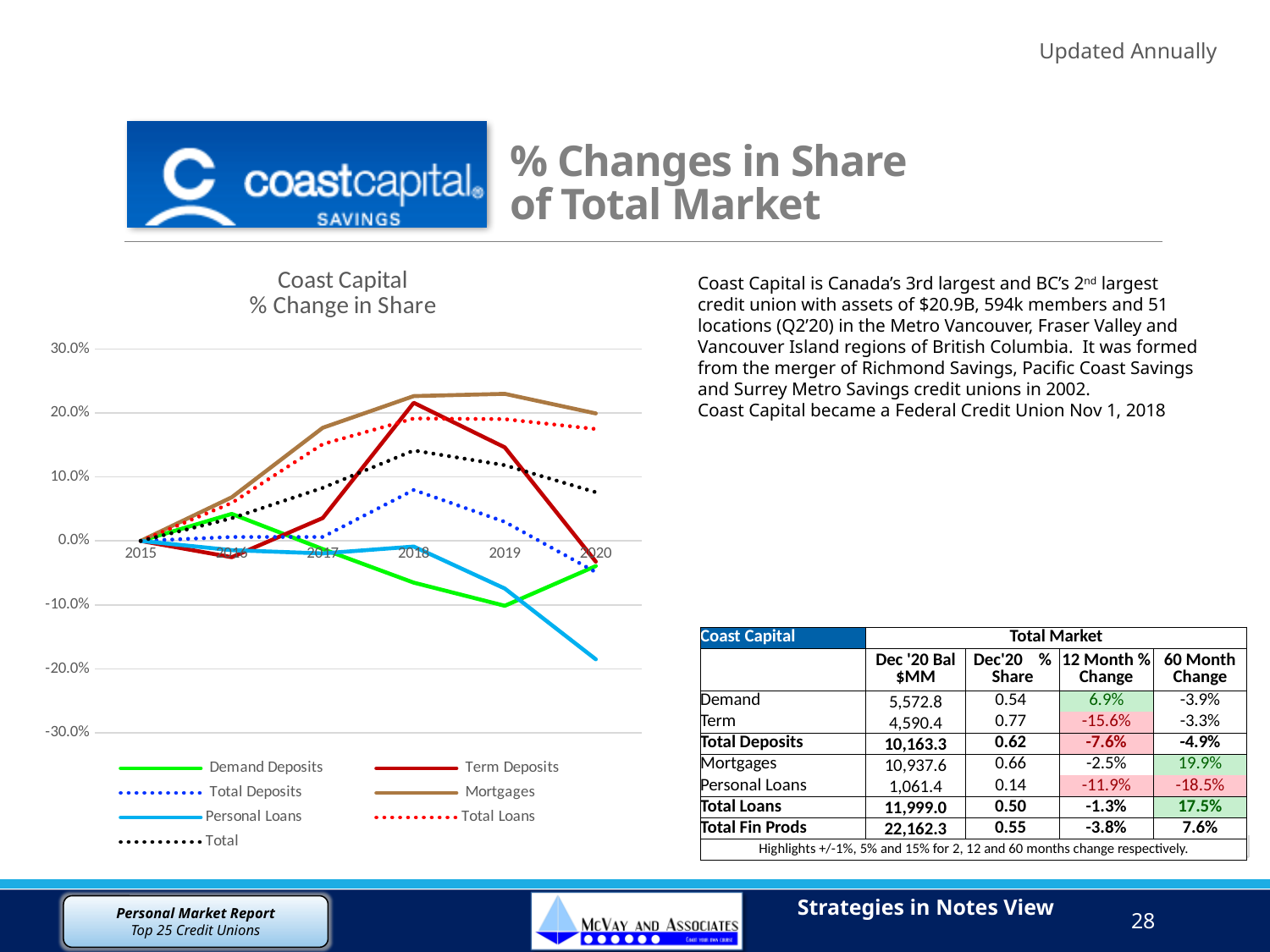
How many years are plotted along the x axis of the chart? 6 Is the value for Personal Loans in 2020 greater or less than -10.0%? less Is the value for Demand Deposits in 2019 greater or less than 0.0%? less What is the title of the chart? Coast Capital % Change in Share How many series does the legend of the chart list? 7 What kind of chart is shown on the slide? line chart Is the value for Mortgages in 2019 greater or less than 20.0%? greater Does the Term Deposits line rise or fall from 2018 to 2020? fall Which series has the highest value in 2020? Mortgages Which series has the lowest value in 2020? Personal Loans In 2020, which is larger: Total Loans or Total Deposits? Total Loans Does the Mortgages line rise or fall from 2015 to 2019? rise